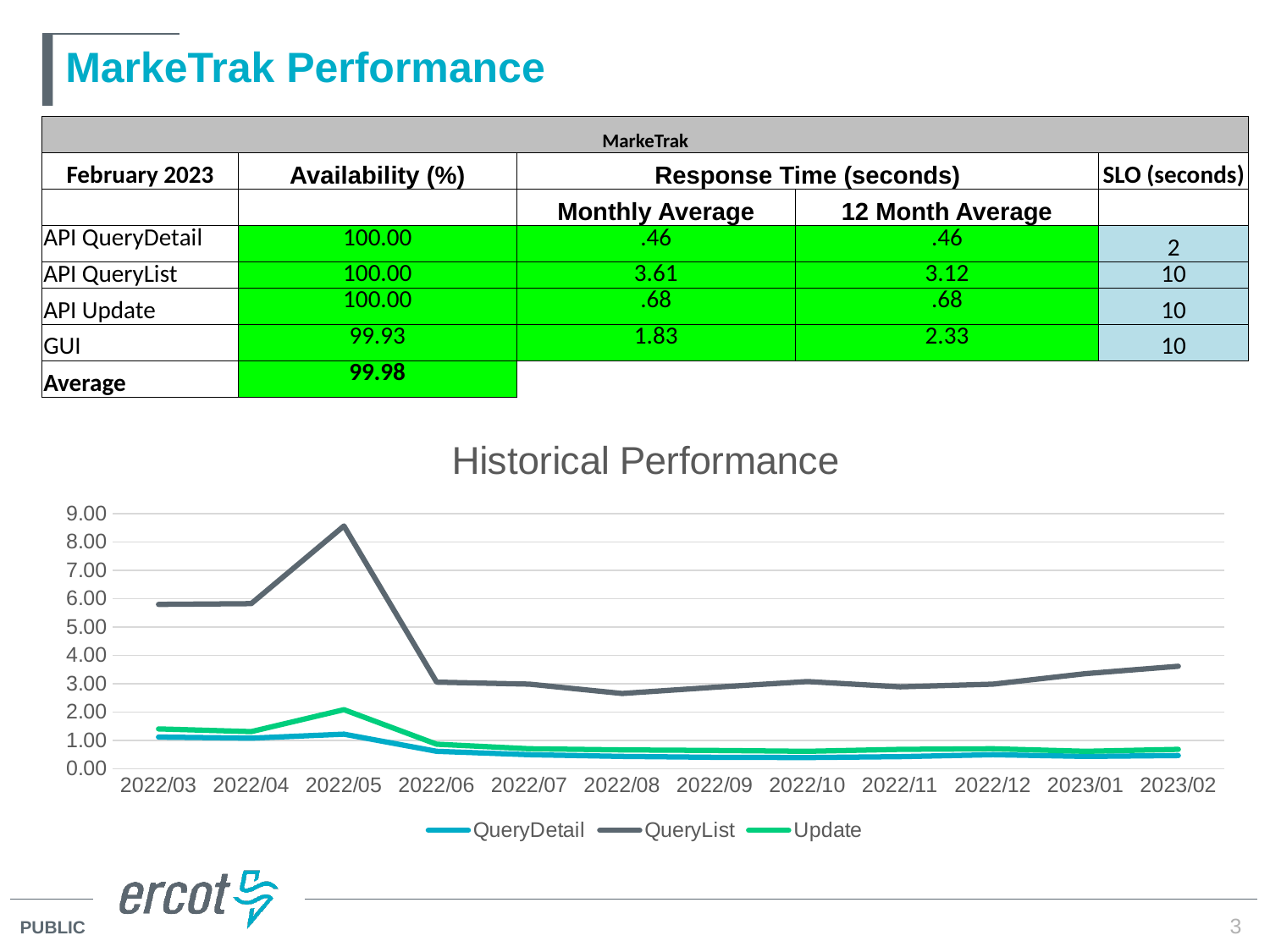
In the Historical Performance chart, in which month is the QueryList series at its lowest? 2022/08 How many months are plotted along the x axis of the Historical Performance chart? 12 In the Historical Performance chart, is the value for QueryDetail in 2023/02 greater or less than 1.00? less In the Historical Performance chart, is the value for QueryList in 2022/08 greater or less than 3.00? less In the Historical Performance chart, which series has the highest values throughout the period? QueryList What is the title of the line chart on the slide? Historical Performance In the Historical Performance chart, is the value for QueryList in 2022/05 greater or less than 8.00? greater In the Historical Performance chart, in which month does the QueryList series reach its peak? 2022/05 How many series does the legend of the Historical Performance chart list? 3 In the Historical Performance chart, does the QueryList series rise or fall between 2022/05 and 2022/06? fall What kind of chart is the Historical Performance chart? line chart In the Historical Performance chart, which is larger in 2022/05: Update or QueryDetail? Update